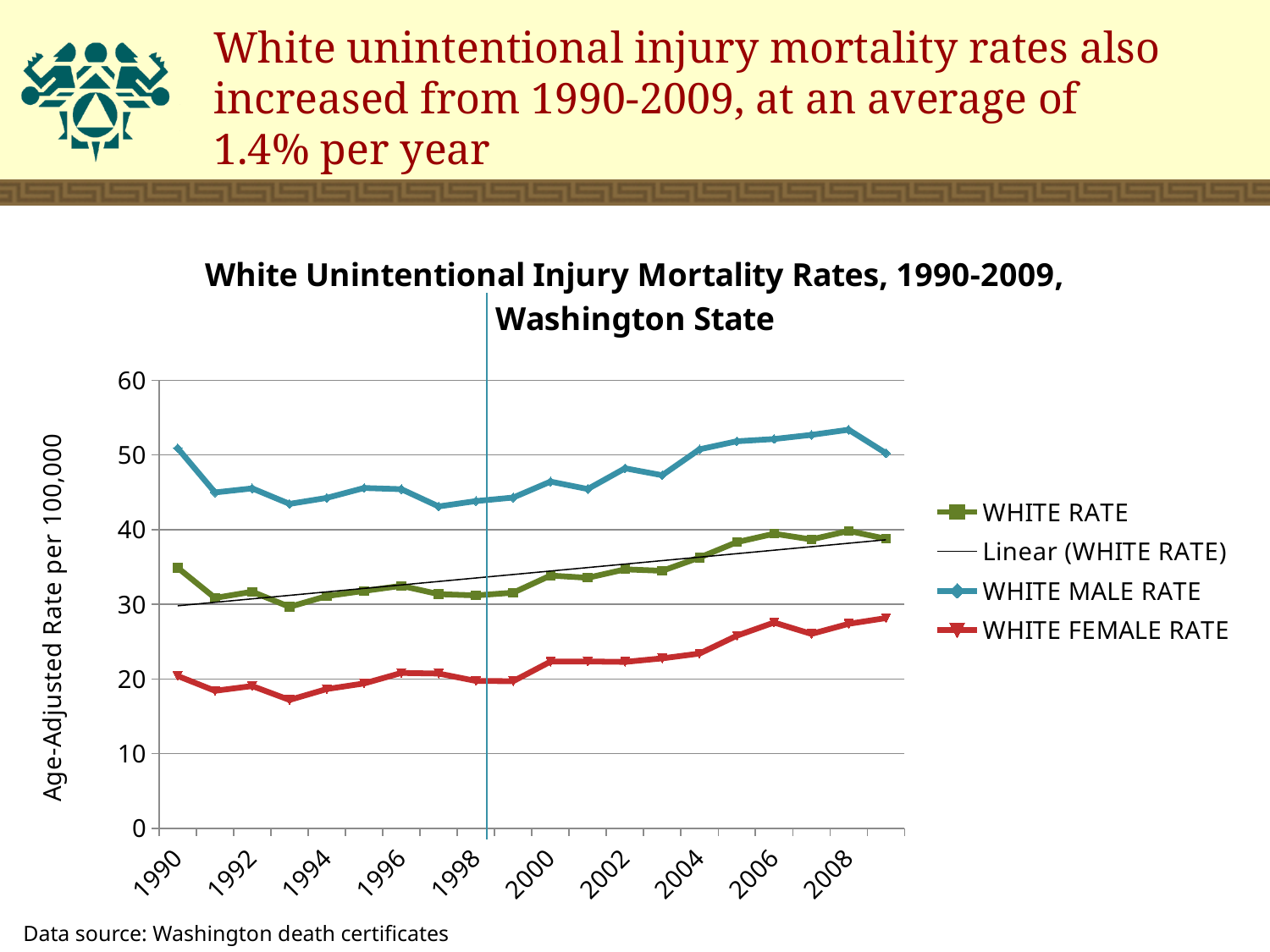
Is the WHITE RATE in 1990 greater or less than 30? greater What is the label on the y axis of the chart? Age-Adjusted Rate per 100,000 How many years are plotted along the x axis of the chart? 20 In which year is the WHITE MALE RATE highest? 2008 Is the WHITE MALE RATE in 1997 greater or less than 50? less Does the WHITE FEMALE RATE generally rise or fall from 2000 to 2009? rise Which is larger in 2000, the WHITE MALE RATE or the WHITE FEMALE RATE? WHITE MALE RATE What kind of chart is shown on the slide? line chart Is the WHITE FEMALE RATE in 1993 greater or less than 20? less In which year is the WHITE FEMALE RATE lowest? 1993 How many entries does the chart legend list? 4